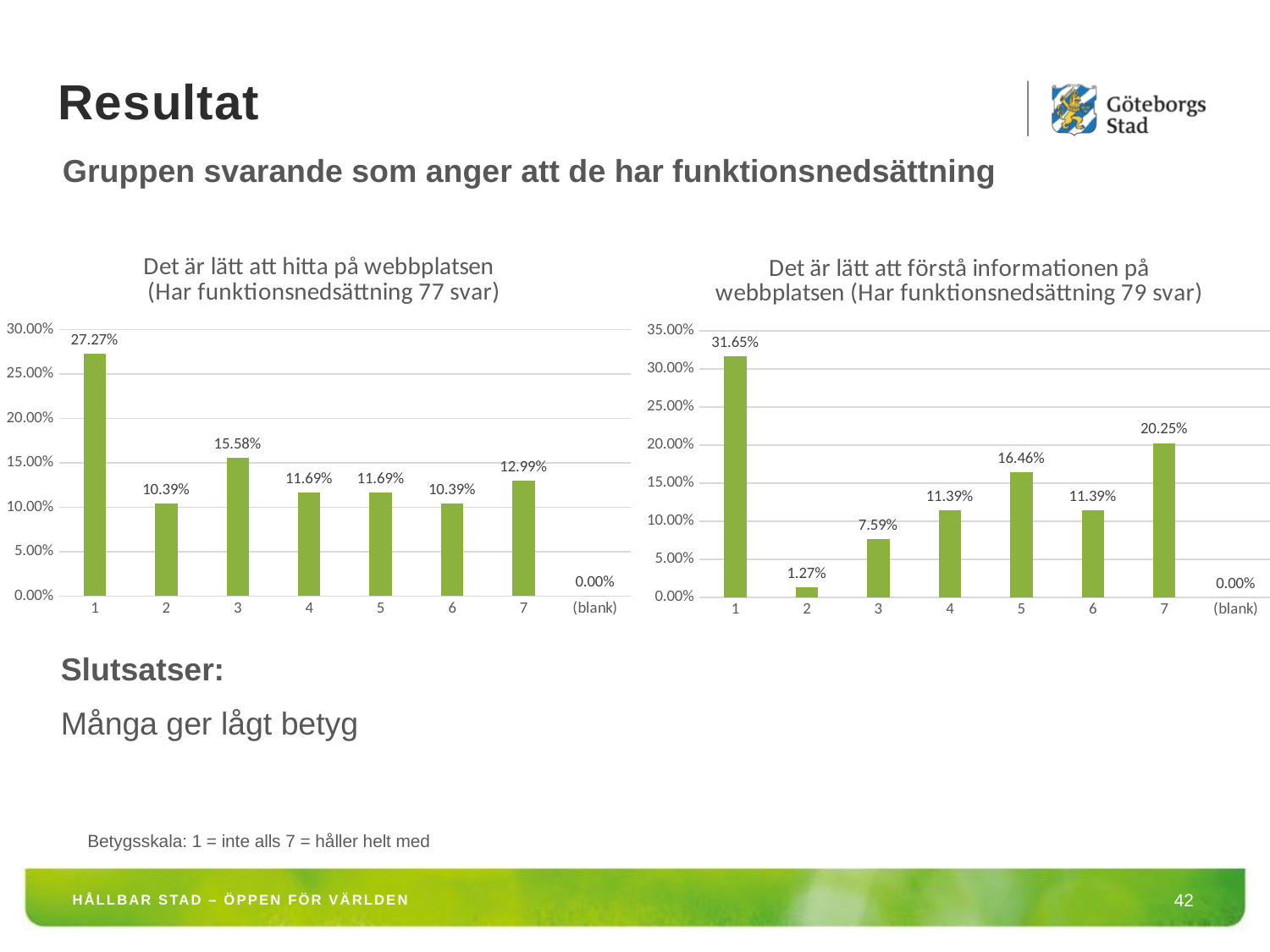
In the left chart 'Det är lätt att hitta på webbplatsen', which category has the highest value? 1 In the left chart 'Det är lätt att hitta på webbplatsen', what is the value for category 1? 27.27% How many categories are shown on the x axis of the left chart 'Det är lätt att hitta på webbplatsen'? 8 In the right chart 'Det är lätt att förstå informationen på webbplatsen', which category has the lowest non-zero value? 2 In the right chart 'Det är lätt att förstå informationen på webbplatsen', what is the value for category 7? 20.25% In the right chart 'Det är lätt att förstå informationen på webbplatsen', what is the value for category 3? 7.59% In the left chart 'Det är lätt att hitta på webbplatsen', what is the value for category 3? 15.58% In the left chart 'Det är lätt att hitta på webbplatsen', which is larger: category 3 or category 7? 3 In the right chart 'Det är lätt att förstå informationen på webbplatsen', is the value for category 5 greater or less than 15.00%? greater In the right chart 'Det är lätt att förstå informationen på webbplatsen', what is the difference between category 1 and category 7? 11.40% How many responses (svar) does the title of the left chart 'Det är lätt att hitta på webbplatsen' state? 77 svar What kind of chart is the right chart 'Det är lätt att förstå informationen på webbplatsen'? Bar chart